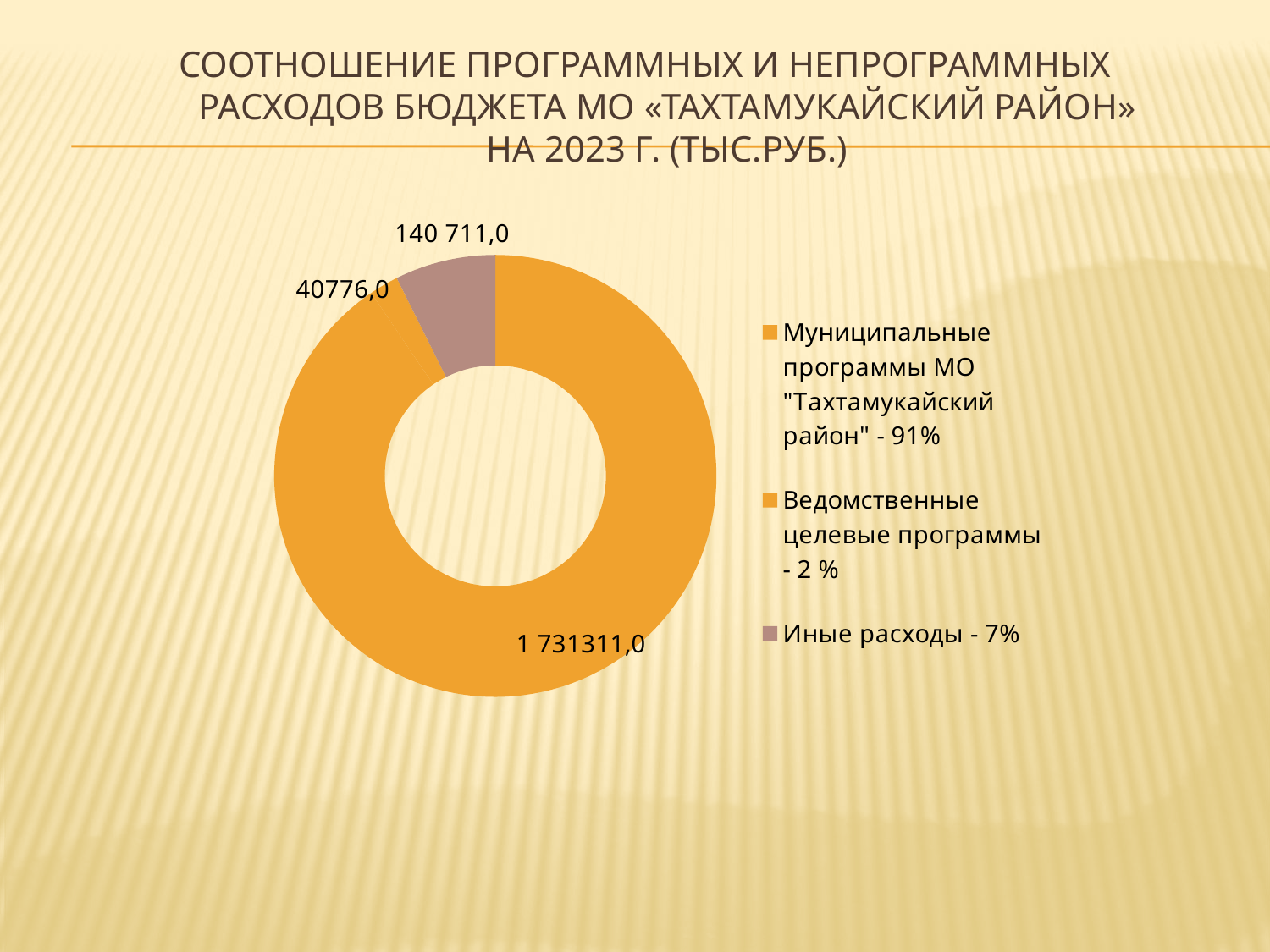
What is the value for Иные расходы? 140 711,0 What share of the chart do Иные расходы represent? 7% What is the value for Муниципальные программы МО "Тахтамукайский район"? 1 731311,0 What is the difference between Иные расходы and Ведомственные целевые программы? 99 935,0 What share of the chart do Муниципальные программы МО "Тахтамукайский район" represent? 91% Which category has the largest slice? Муниципальные программы МО "Тахтамукайский район" What type of chart is shown on the slide? doughnut chart How many categories are shown in the chart? 3 What colour is the slice for Иные расходы? brownish pink What is the value for Ведомственные целевые программы? 40776,0 Which category has the smallest slice? Ведомственные целевые программы Which is larger, Иные расходы or Ведомственные целевые программы? Иные расходы